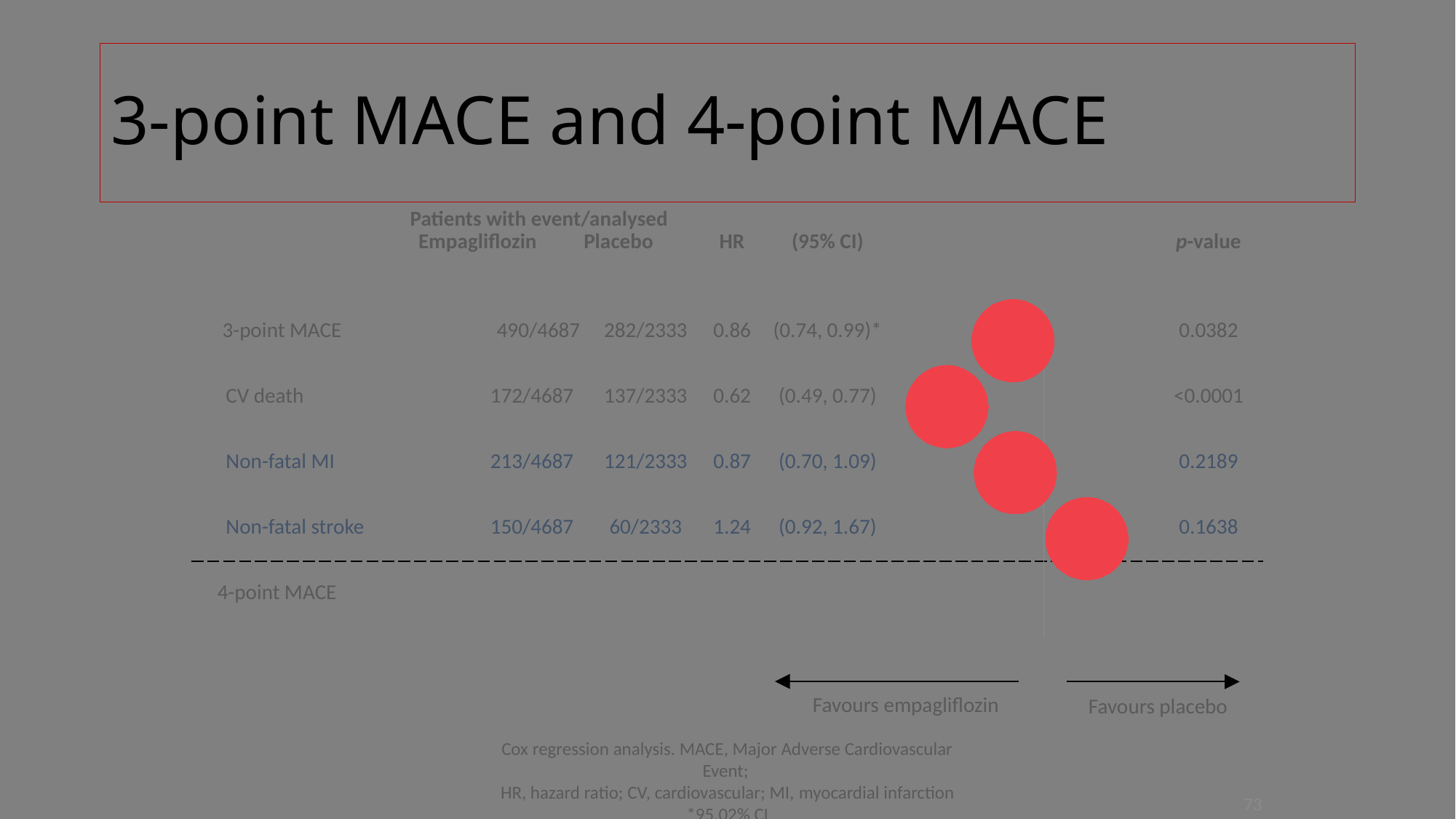
What is the hazard ratio (HR) for CV death? 0.62 What is the difference between the hazard ratios for Non-fatal MI and CV death? 0.25 What does the left-pointing arrow below the plot indicate? Favours empagliflozin What is the hazard ratio (HR) for Non-fatal stroke? 1.24 How many outcomes have a hazard ratio point plotted in the forest plot? 4 What is the 95% CI shown for 3-point MACE? (0.74, 0.99)* What is the p-value for Non-fatal MI? 0.2189 How many patients with event/analysed are shown for Empagliflozin in the 3-point MACE row? 490/4687 Which has a larger hazard ratio, 3-point MACE or Non-fatal stroke? Non-fatal stroke Which outcome has the highest hazard ratio in the plot? Non-fatal stroke Which outcome has the lowest hazard ratio in the plot? CV death Is the hazard ratio point for Non-fatal stroke plotted to the left or right of the vertical reference line (HR = 1)? right